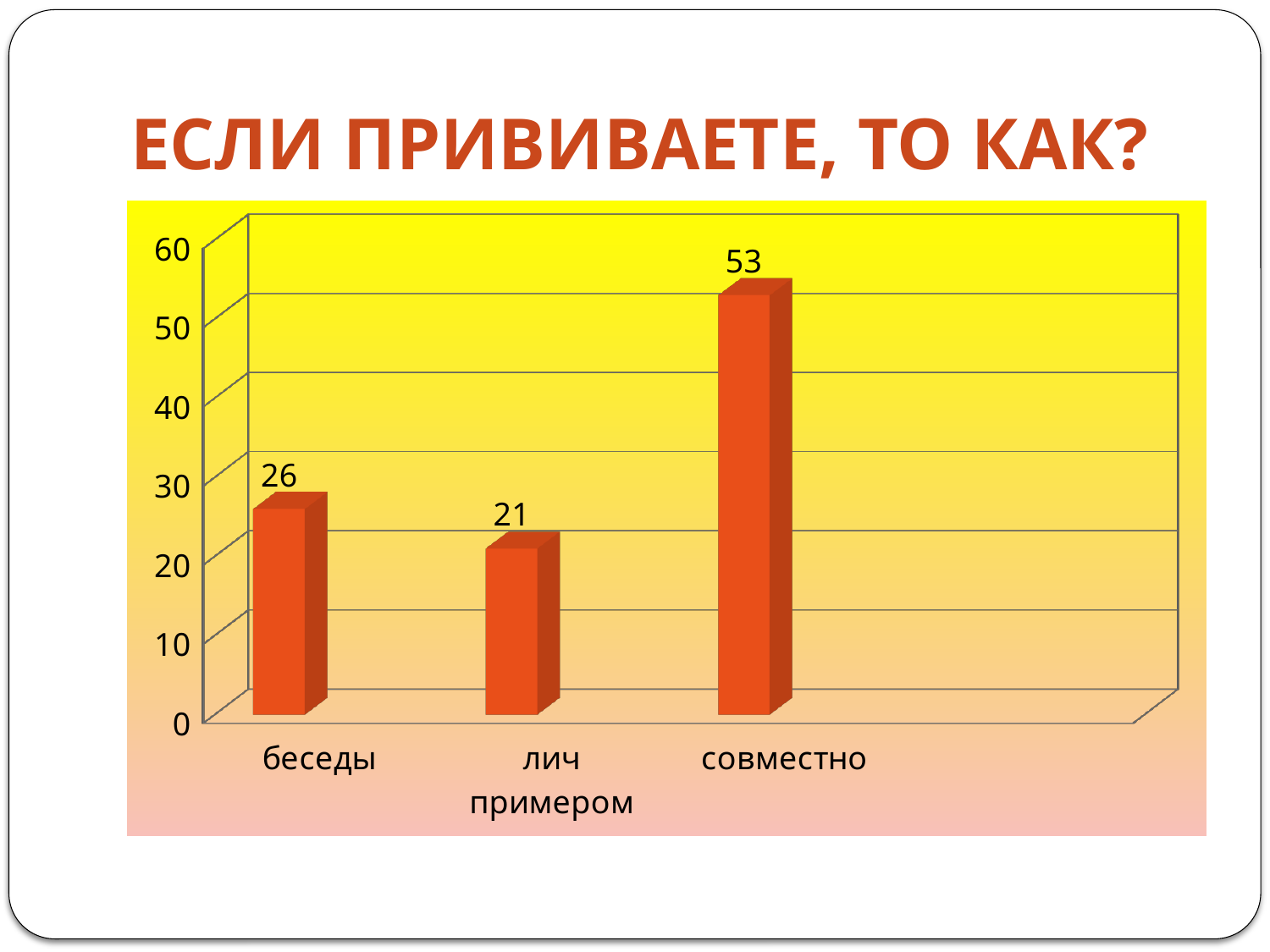
Which category has the highest value? совместно Which is larger, the value for беседы or the value for лич примером? беседы What is the title of the slide? ЕСЛИ ПРИВИВАЕТЕ, ТО КАК? What is the value for лич примером? 21 What is the difference between the values for беседы and лич примером? 5 How many categories are shown on the chart? 3 Is the value for совместно greater or less than 50? greater What kind of chart is shown on the slide? bar chart What is the value for беседы? 26 What is the difference between the values for совместно and беседы? 27 Which category has the lowest value? лич примером What is the value for совместно? 53